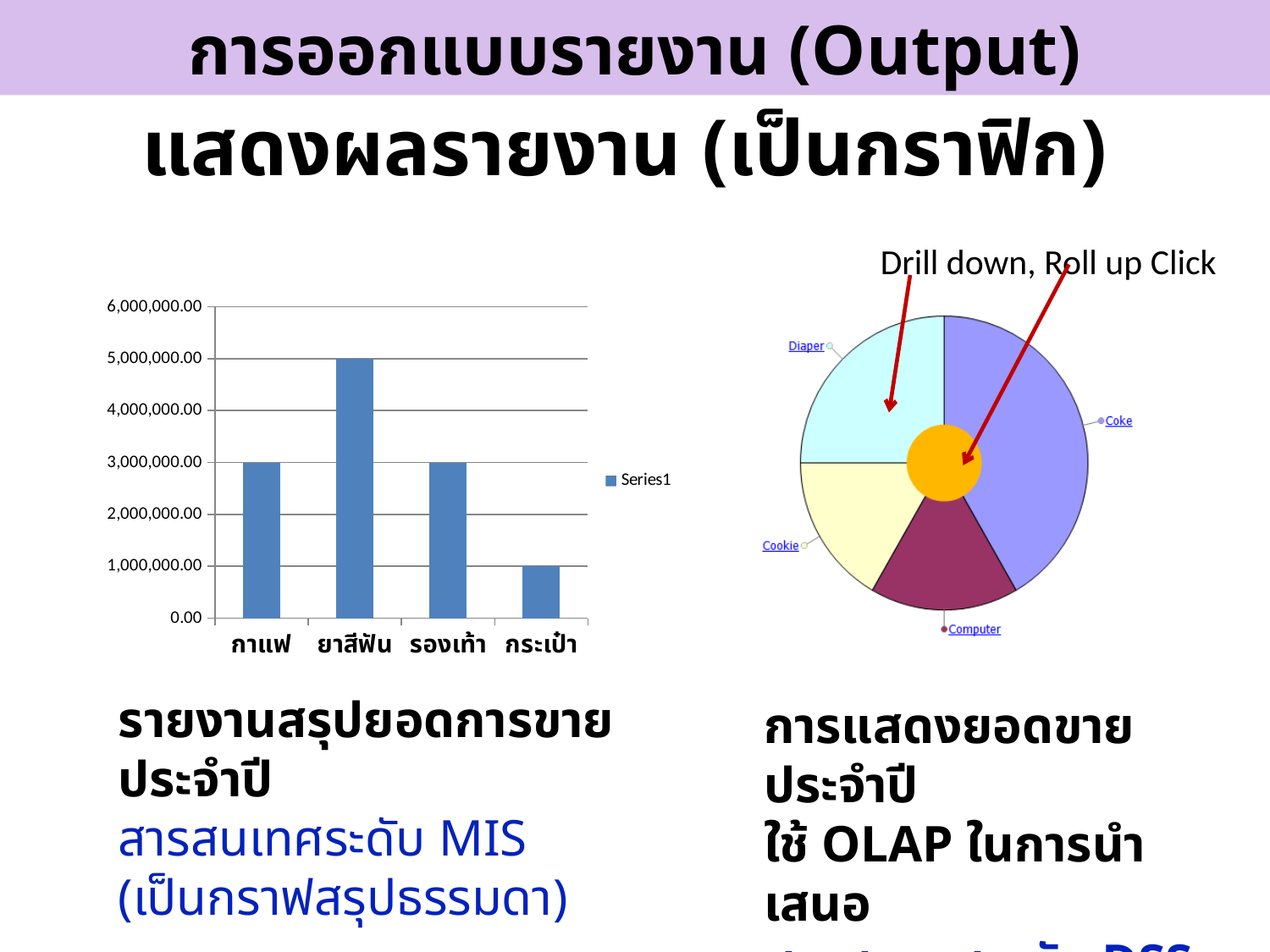
In the bar chart on the left, which category has the lowest value? กระเป๋า In the pie chart on the right, which slice is the largest? Coke What kind of chart is shown on the left side of the slide? Bar chart In the bar chart on the left, how many categories are shown on the x axis? 4 In the bar chart on the left, how many series does the legend list? 1 In the bar chart on the left, what is the value for กาแฟ? 3,000,000.00 In the bar chart on the left, what is the difference between the values for ยาสีฟัน and กระเป๋า? 4,000,000.00 In the pie chart on the right, how many labeled slices are there? 4 In the bar chart on the left, which category has the highest value? ยาสีฟัน In the bar chart on the left, what is the value for ยาสีฟัน? 5,000,000.00 In the bar chart on the left, which is larger, the value for รองเท้า or the value for กระเป๋า? รองเท้า In the bar chart on the left, what is the value for กระเป๋า? 1,000,000.00